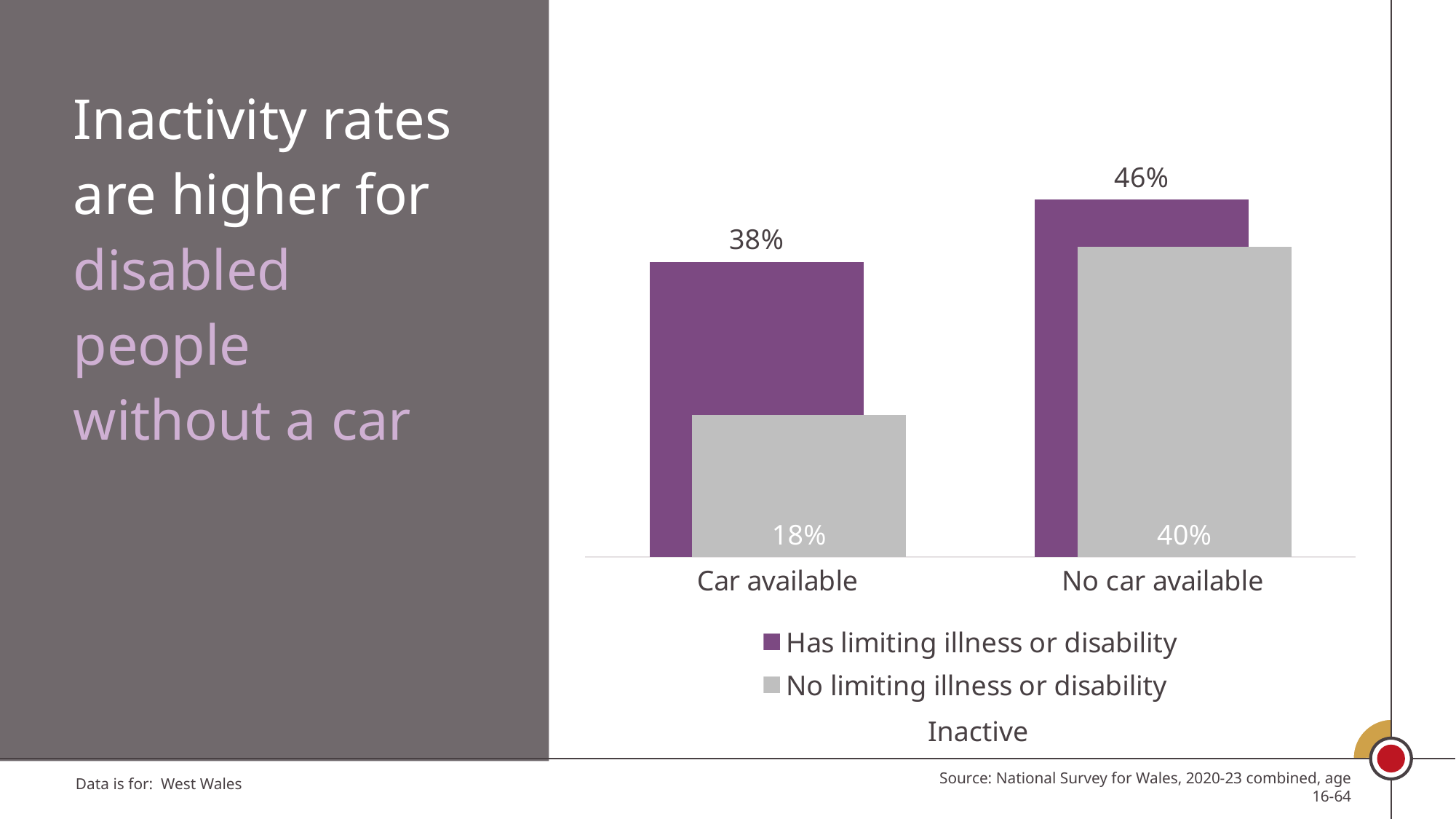
How many categories are shown on the x axis? 2 What is the difference in inactivity rate between people with and without a limiting illness or disability when a car is available? 20 percentage points How many series does the legend list? 2 What is the inactivity rate for people with a limiting illness or disability who have no car available? 46% What is the inactivity rate for people with no limiting illness or disability who have no car available? 40% Which group has the highest inactivity rate on the chart? Has limiting illness or disability, No car available Which is larger: the inactivity rate for people with a limiting illness or disability with a car available, or for people with no limiting illness or disability with no car available? No limiting illness or disability with no car available What is the inactivity rate for people with a limiting illness or disability who have a car available? 38% Which group has the lowest inactivity rate on the chart? No limiting illness or disability, Car available What kind of chart is shown on the slide? Bar chart What is the inactivity rate for people with no limiting illness or disability who have a car available? 18% What is the difference in inactivity rate for people with a limiting illness or disability between no car available and car available? 8 percentage points